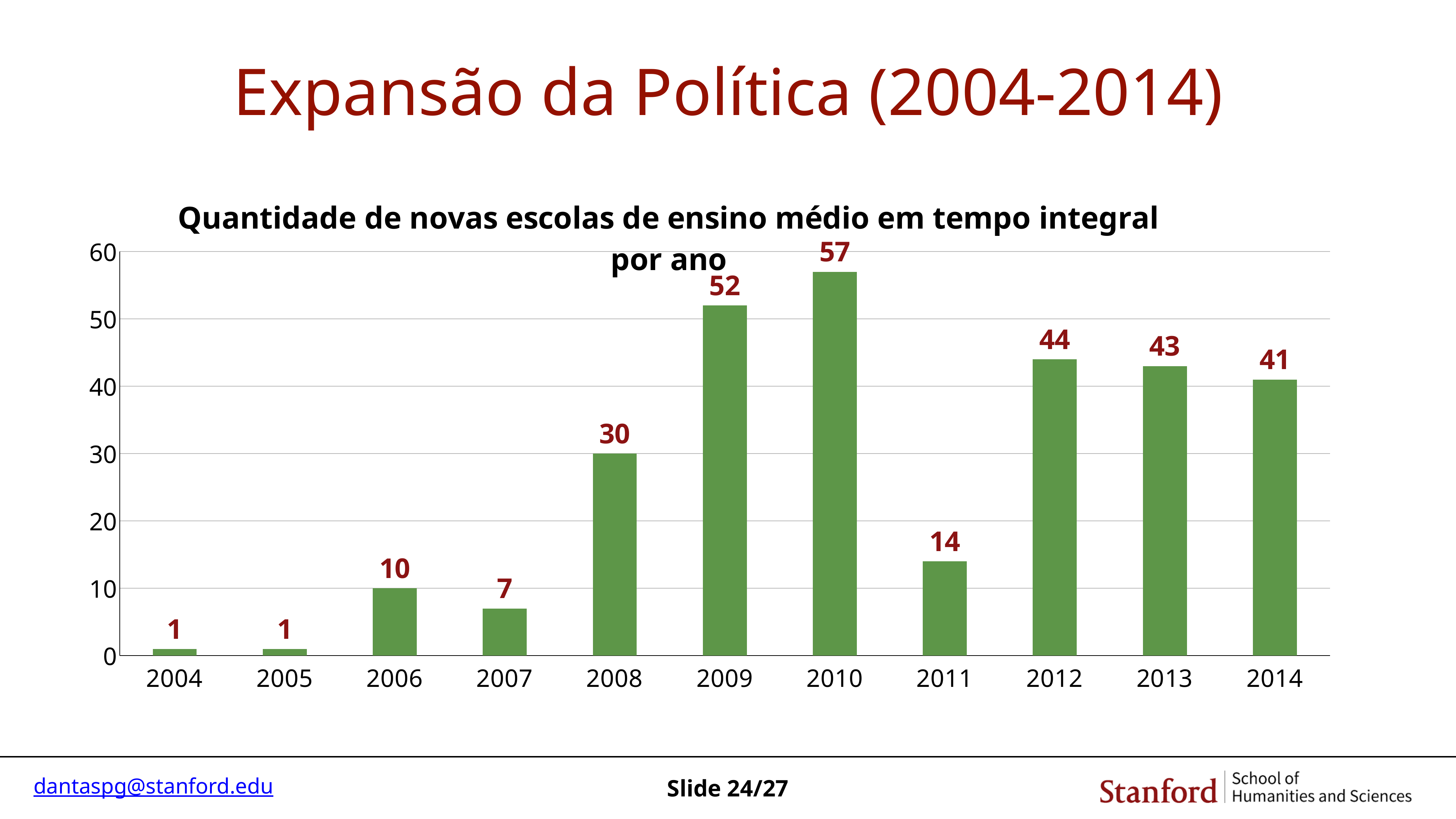
What is the title of the chart? Quantidade de novas escolas de ensino médio em tempo integral por ano What is the value for 2010? 57 Is the value for 2009 greater or less than 50? greater What is the value for 2011? 14 Which year has the highest value? 2010 What is the difference between the values for 2010 and 2011? 43 Which years have the lowest value? 2004 and 2005 What is the value for 2008? 30 What kind of chart is shown on the slide? Bar chart What is the difference between the values for 2009 and 2008? 22 Which is larger, the value for 2012 or the value for 2014? 2012 How many years are shown on the x axis? 11